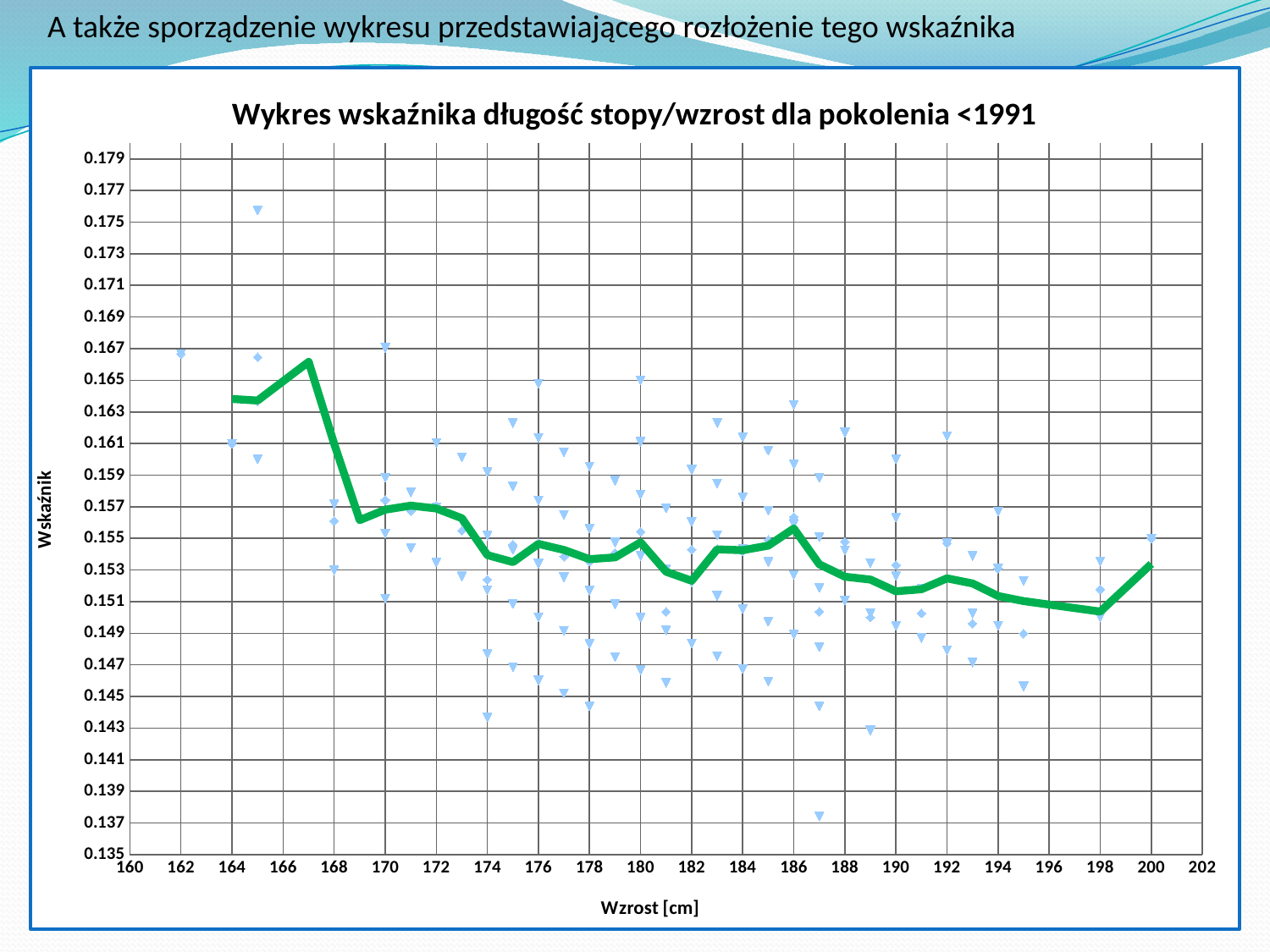
What kind of chart is shown on the slide? scatter chart Is the value of the green line at height 167 greater or less than 0.163? greater At which height (Wzrost) does the green line reach its lowest point? 198 What is the label of the x axis? Wzrost [cm] Does the green line generally rise or fall as height increases from 167 to 198? fall At which height (Wzrost) does the green line reach its highest point? 167 What is the title of the chart? Wykres wskaźnika długość stopy/wzrost dla pokolenia <1991 Is the value of the green line at height 169 greater or less than 0.159? less Is the value of the green line at height 198 greater or less than 0.153? less Which is larger, the green line value at height 164 or at height 198? 164 What is the highest value shown on the y axis? 0.179